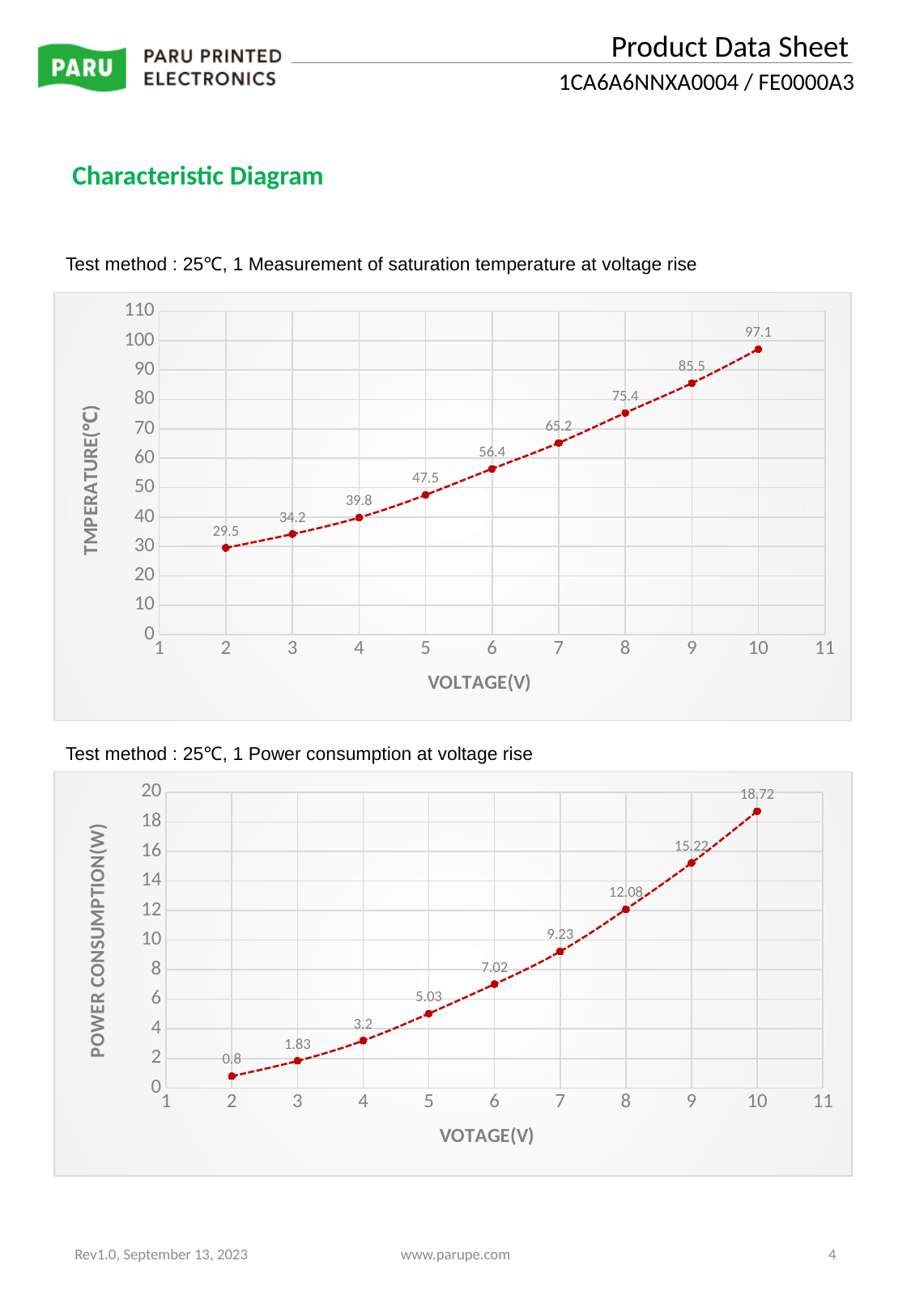
In the bottom chart (power consumption vs voltage), what is the difference between the power consumption at 9 V and at 8 V? 3.14 In the bottom chart (power consumption vs voltage), what is the power consumption at 7 V? 9.23 In the bottom chart (power consumption vs voltage), what is the power consumption at 3 V? 1.83 What kind of chart is the bottom chart (power consumption vs voltage)? line chart In the top chart (temperature vs voltage), what is the difference between the temperature at 10 V and at 2 V? 67.6 In the top chart (temperature vs voltage), how many data points are plotted? 9 In the bottom chart (power consumption vs voltage), at which voltage is the power consumption highest? 10 In the top chart (temperature vs voltage), at which voltage is the temperature lowest? 2 In the top chart (temperature vs voltage), what is the temperature at 10 V? 97.1 In the top chart (temperature vs voltage), what is the temperature at 6 V? 56.4 In the top chart (temperature vs voltage), does the temperature rise or fall as voltage increases? rise In the top chart (temperature vs voltage), what is the label of the y axis? TMPERATURE(℃)